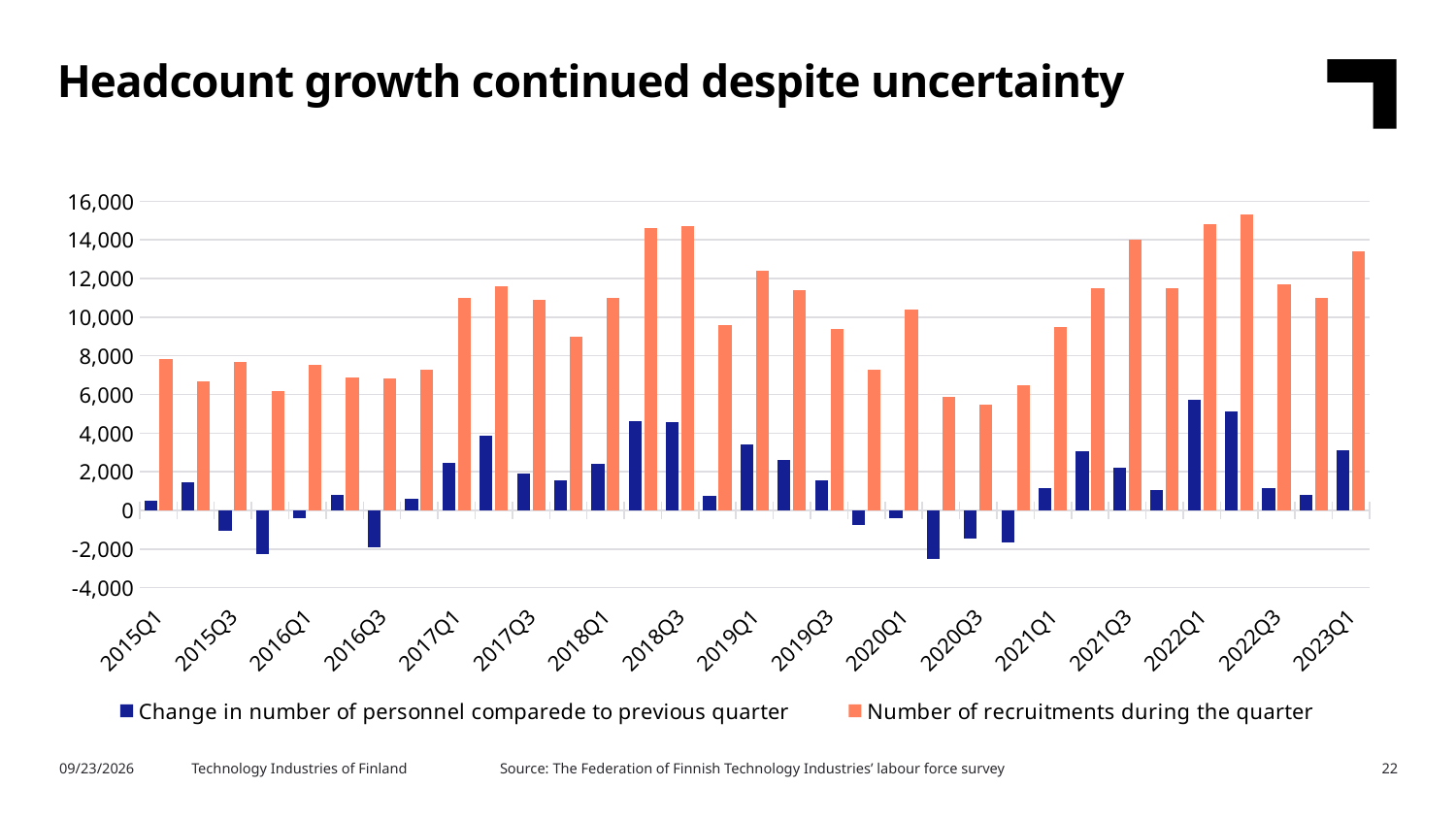
Is the number of recruitments during the quarter for 2020Q1 greater or less than 8,000? greater Is the number of recruitments during the quarter for 2023Q1 greater or less than 12,000? greater Is the number of recruitments during the quarter for 2015Q1 greater or less than 6,000? greater Do the number of recruitments during the quarter rise or fall from 2020Q3 to 2022Q3? Rise Which series is shown in orange in the chart? Number of recruitments during the quarter Which quarter has the highest change in number of personnel compared to previous quarter? 2022Q1 Which quarter has the highest number of recruitments during the quarter? 2022Q2 Which quarter has more recruitments during the quarter, 2018Q3 or 2020Q3? 2018Q3 How many series does the legend list? 2 What kind of chart is shown on the slide? Bar chart What is the title of the slide containing the chart? Headcount growth continued despite uncertainty